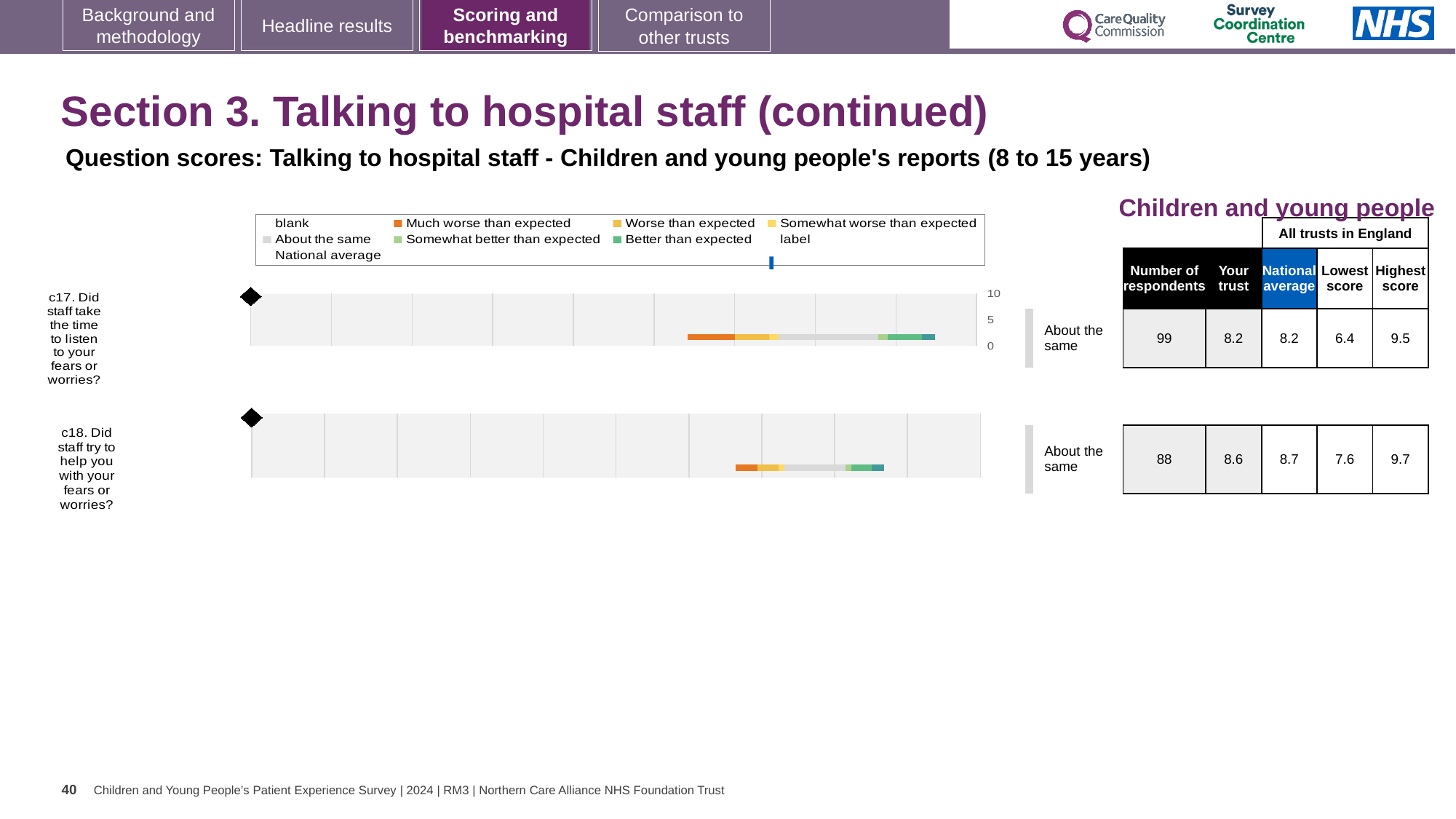
What is the highest value shown on the chart's vertical axis? 10 What kind of chart is used to show the benchmarking for question c17? bar chart According to the table beside the chart, what is the national average for c18 (Did staff try to help you with your fears or worries?)? 8.7 In the chart legend, which colour represents 'Much worse than expected'? orange Which question had more respondents, c17 or c18? c17 What benchmark category is shown next to the chart for c18? About the same What is the difference between the highest score and the lowest score for c18? 2.1 How many survey questions are charted on the slide? 2 According to the table beside the chart, what is the 'Your trust' score for c17 (Did staff take the time to listen to your fears or worries?)? 8.2 Is the 'Your trust' score higher for c17 or for c18? c18 What is the difference between the highest score and the lowest score for c17? 3.1 How many respondents answered question c17? 99